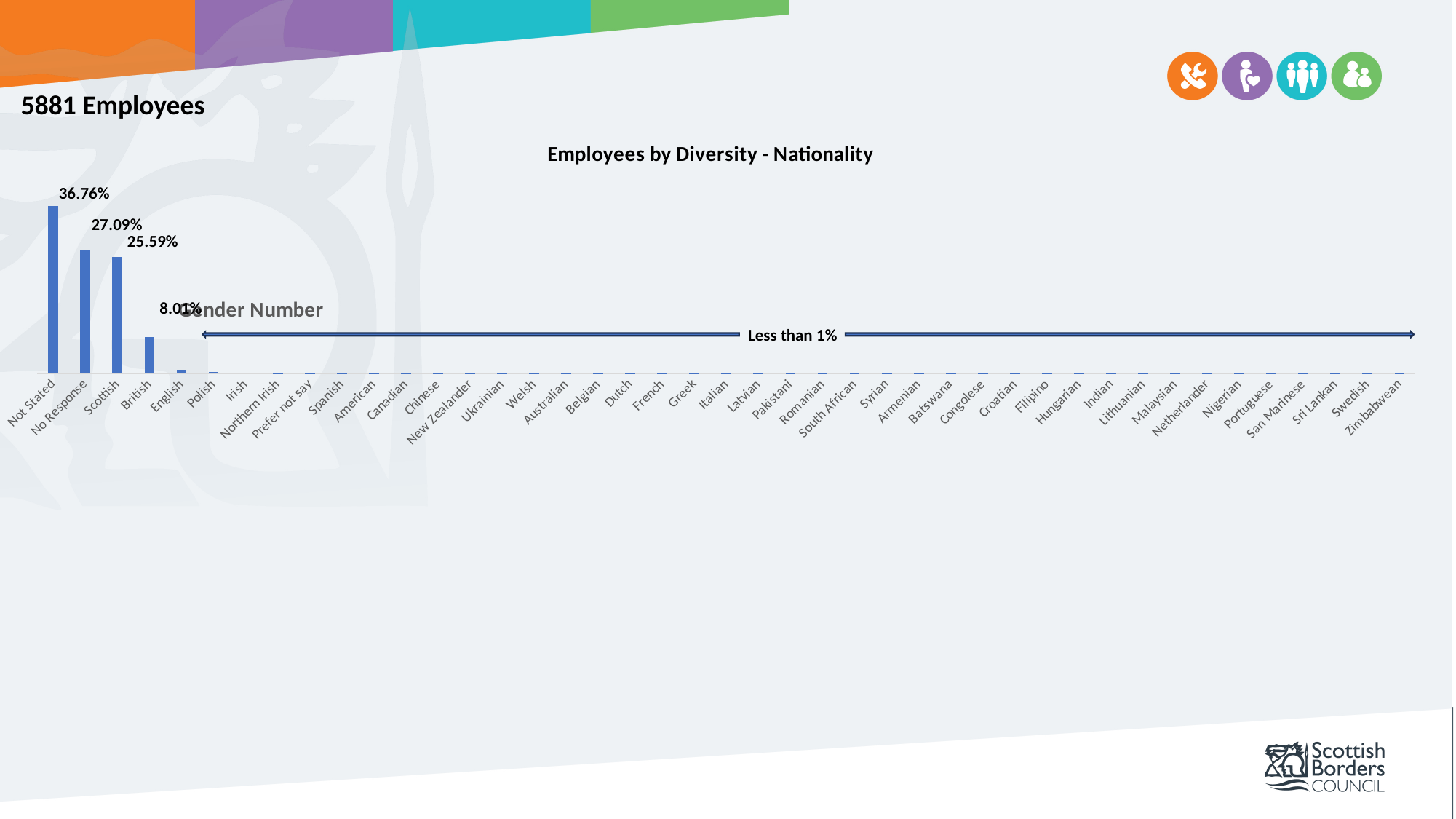
Which is larger, the value for Scottish or the value for British? Scottish Which category has the highest value in the Employees by Diversity - Nationality chart? Not Stated What kind of chart is shown on the slide? Bar chart What is the value for No Response in the Employees by Diversity - Nationality chart? 27.09% What is the value for British in the Employees by Diversity - Nationality chart? 8.01% What is the value for Scottish in the Employees by Diversity - Nationality chart? 25.59% What is the difference between the values for Scottish and British? 17.58% What is the difference between the values for Not Stated and No Response? 9.67% What is the title of the chart? Employees by Diversity - Nationality What does the long horizontal arrow label say about the nationalities from Polish onwards? Less than 1% What is the value for Not Stated in the Employees by Diversity - Nationality chart? 36.76% What is the difference between the values for No Response and Scottish? 1.50%